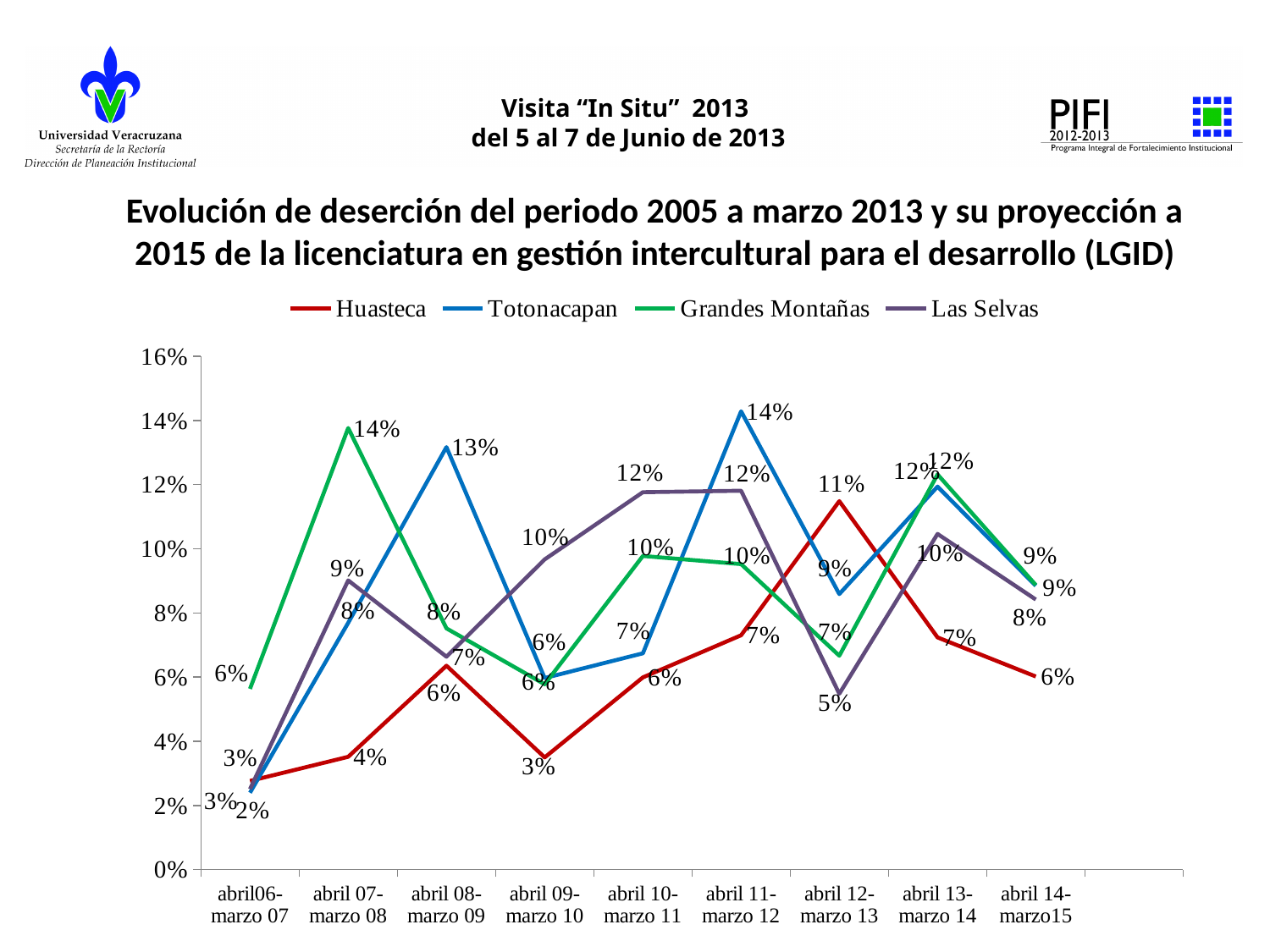
What is the value for Grandes Montañas in abril 07-marzo 08? 14% Which series has the highest value in abril 08-marzo 09? Totonacapan Which series has the lowest value in abril 09-marzo 10? Huasteca What is the difference between Totonacapan and Huasteca in abril 11-marzo 12? 7% How many periods are shown on the x axis? 9 What is the value for Totonacapan in abril 11-marzo 12? 14% How many series does the legend list? 4 Does the Huasteca line rise or fall from abril 12-marzo 13 to abril 14-marzo15? Fall What is the value for Huasteca in abril 12-marzo 13? 11% Which is larger in abril 10-marzo 11: Las Selvas or Huasteca? Las Selvas What is the value for Las Selvas in abril 12-marzo 13? 5% What kind of chart is shown on the slide? Line chart